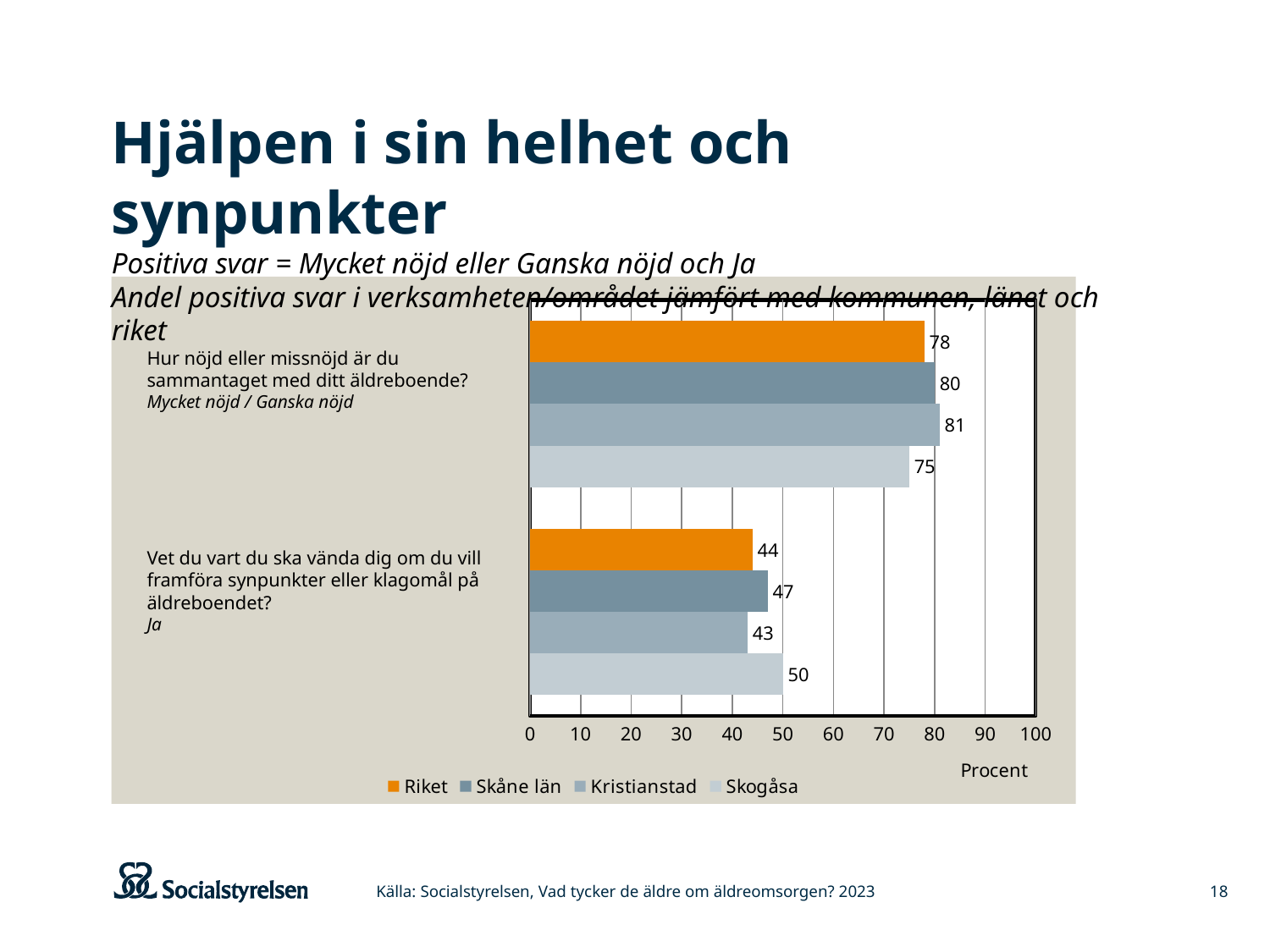
What is the difference between the Skogåsa value and the Riket value on the question "Vet du vart du ska vända dig om du vill framföra synpunkter eller klagomål på äldreboendet?"? 6 Is the value for Skogåsa on the question "Hur nöjd eller missnöjd är du sammantaget med ditt äldreboende?" greater or less than 70? greater What is the value for Skåne län on the question "Vet du vart du ska vända dig om du vill framföra synpunkter eller klagomål på äldreboendet?"? 47 What kind of chart is shown on the slide? Bar chart Which is larger on the question "Hur nöjd eller missnöjd är du sammantaget med ditt äldreboende?": the value for Skåne län or the value for Skogåsa? Skåne län What is the value for Skogåsa on the question "Vet du vart du ska vända dig om du vill framföra synpunkter eller klagomål på äldreboendet?"? 50 What is the value for Riket on the question "Hur nöjd eller missnöjd är du sammantaget med ditt äldreboende?"? 78 How many series does the legend list? 4 What is the label of the x axis of the chart? Procent Which series has the lowest value on the question "Vet du vart du ska vända dig om du vill framföra synpunkter eller klagomål på äldreboendet?"? Kristianstad What is the value for Kristianstad on the question "Hur nöjd eller missnöjd är du sammantaget med ditt äldreboende?"? 81 Which series has the highest value on the question "Hur nöjd eller missnöjd är du sammantaget med ditt äldreboende?"? Kristianstad